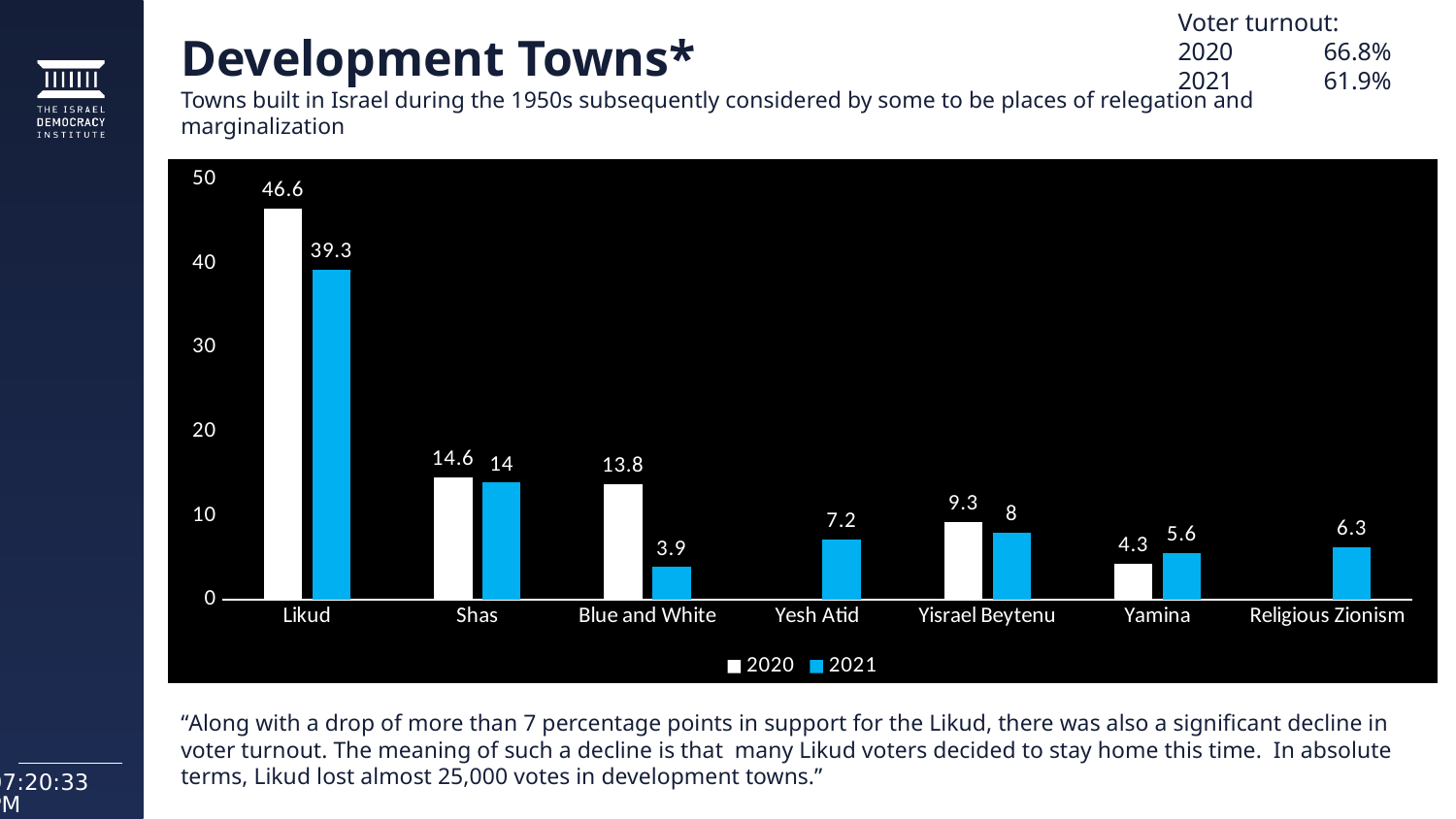
What is the difference between Likud's 2020 and 2021 values? 7.3 Which is larger: Yisrael Beytenu in 2020 or Yisrael Beytenu in 2021? 2020 Which colour represents the 2021 series in the chart? blue Is the value for Shas in 2020 greater or less than 10? greater Which party has the highest value in 2021? Likud How many parties are shown on the x axis? 7 Which party has the lowest value in 2021? Blue and White How many series does the legend list? 2 What kind of chart is shown on the slide? bar chart What is the value for Blue and White in 2021? 3.9 What is the value for Likud in 2020? 46.6 What is the value for Yamina in 2021? 5.6